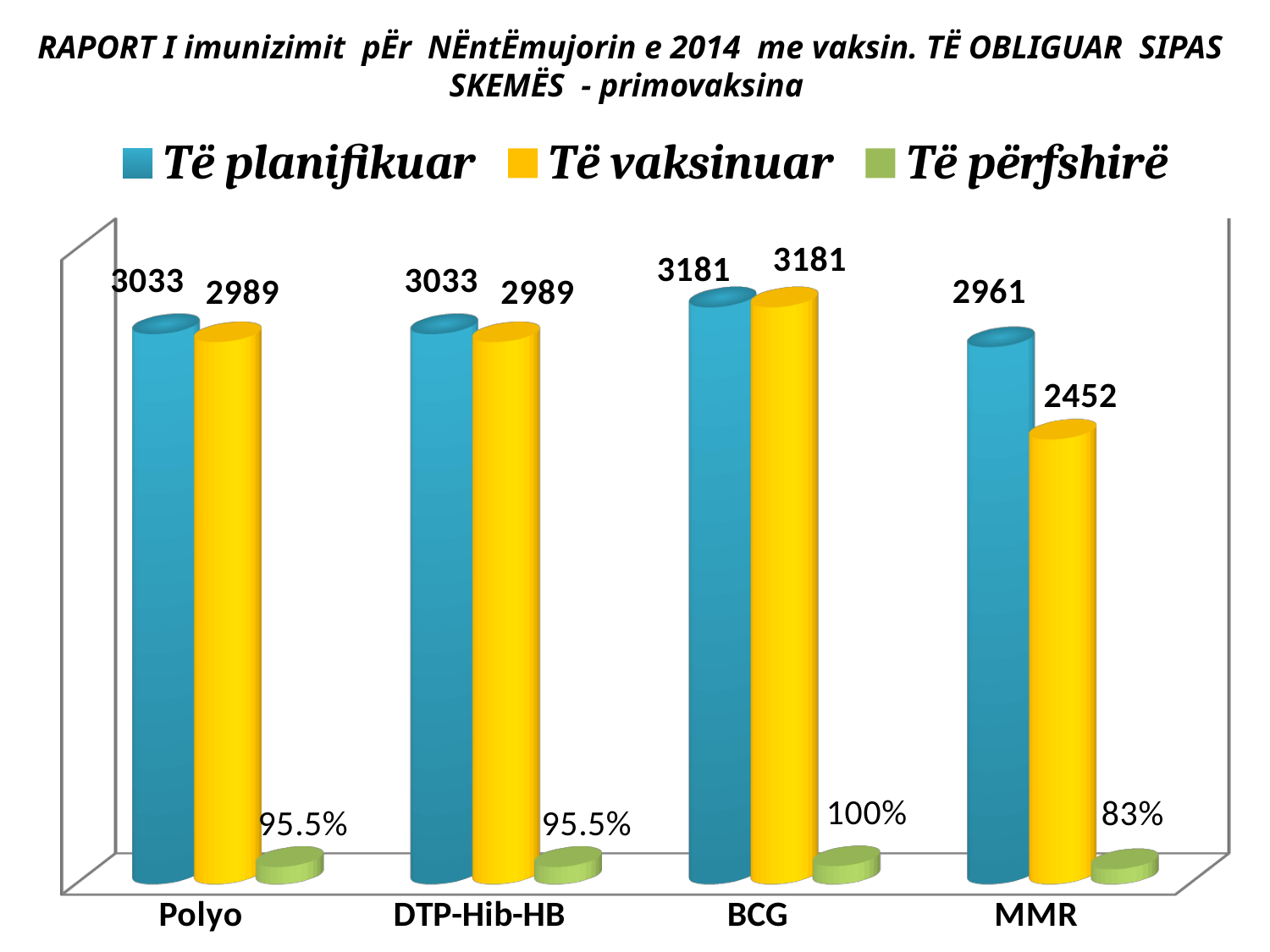
What is the difference between 'Të planifikuar' and 'Të vaksinuar' for Polyo? 44 Which category has the lowest 'Të vaksinuar' value? MMR What is the 'Të përfshirë' value for BCG? 100% Which is larger: the 'Të vaksinuar' value for BCG or for MMR? BCG Which category has the highest 'Të planifikuar' value? BCG What is the 'Të vaksinuar' value for MMR? 2452 What kind of chart is shown on the slide? Bar chart What is the 'Të planifikuar' value for Polyo? 3033 What is the 'Të vaksinuar' value for DTP-Hib-HB? 2989 How many categories are shown on the x axis? 4 What is the difference between 'Të planifikuar' and 'Të vaksinuar' for MMR? 509 How many series does the legend list? 3